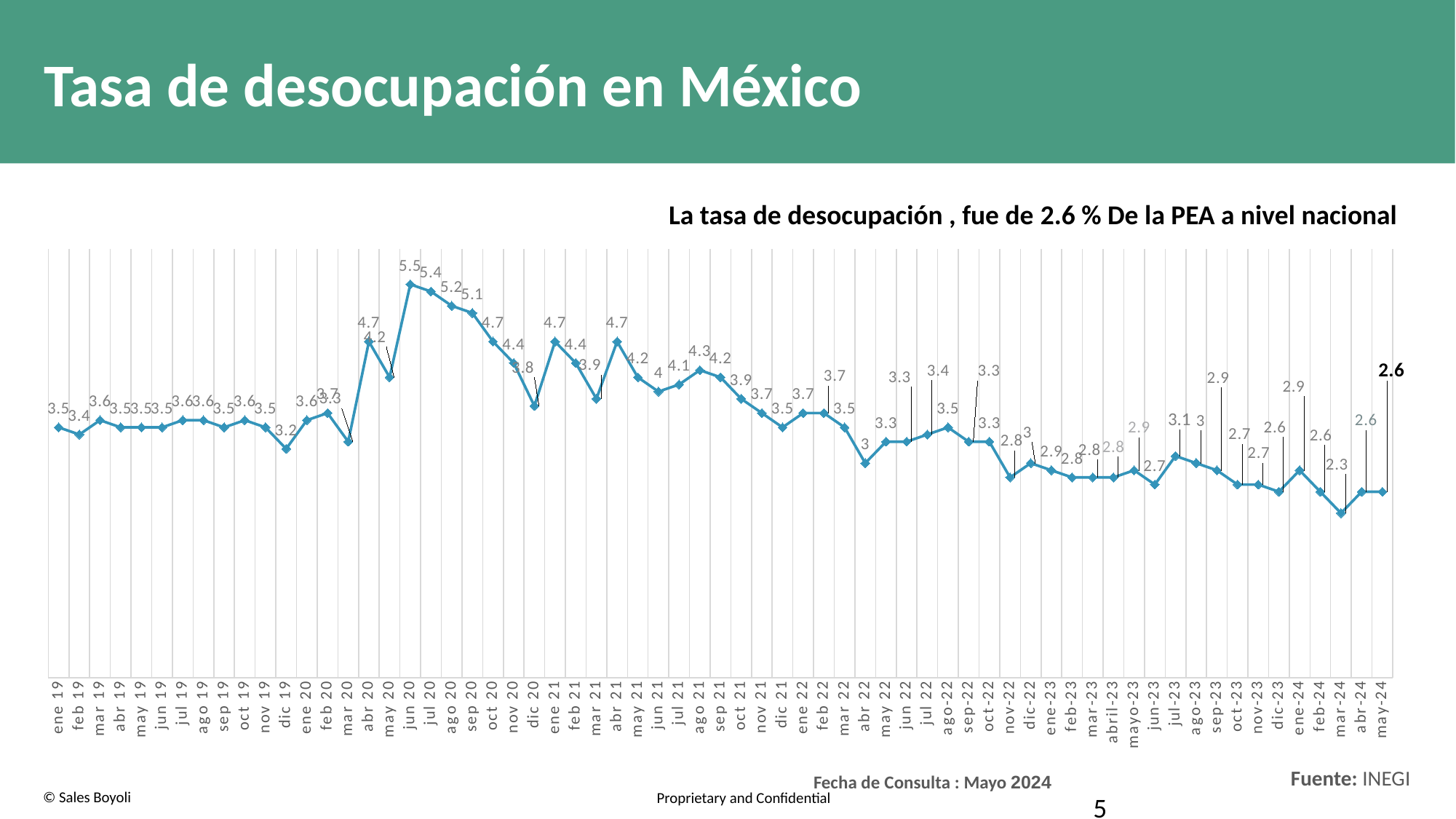
What is the value for dic 19? 3.2 What is the difference between the value for jun 20 and the value for mar-24? 3.2 Which month has the lowest value on the chart? mar-24 What is the value for mar-24? 2.3 Which month has the highest value on the chart? jun 20 Do the values generally rise or fall from jun 20 to may-24? fall What is the value for ene 19? 3.5 What is the title of the slide? Tasa de desocupación en México What kind of chart is shown on the slide? line chart What is the value for jun 20? 5.5 What is the unemployment rate value for may-24? 2.6 Which is larger, the value for jun 20 or the value for ene 19? jun 20